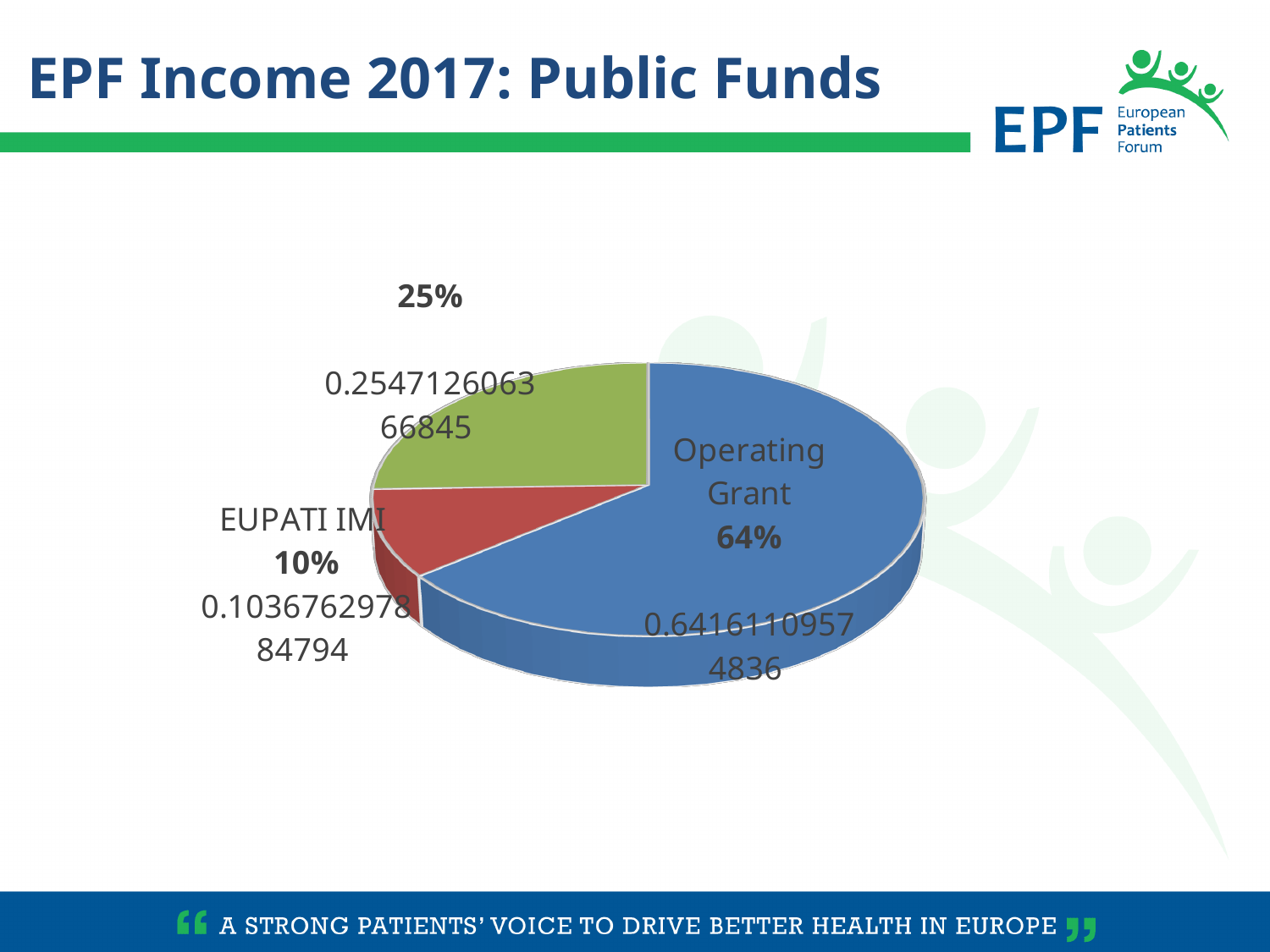
What kind of chart is shown on the slide? pie chart What colour is the Operating Grant slice? blue Which is larger, the Operating Grant slice or the EUPATI IMI slice? Operating Grant Which slice of the pie is the smallest? EUPATI IMI What is the title of the slide containing the pie chart? EPF Income 2017: Public Funds How many slices does the pie chart have? 3 What share of the pie does Operating Grant represent? 64% What percentage is shown for the green slice of the pie? 25% What share of the pie does EUPATI IMI represent? 10% Which slice of the pie is the largest? Operating Grant What is the difference in percentage points between the Operating Grant share and the EUPATI IMI share? 54